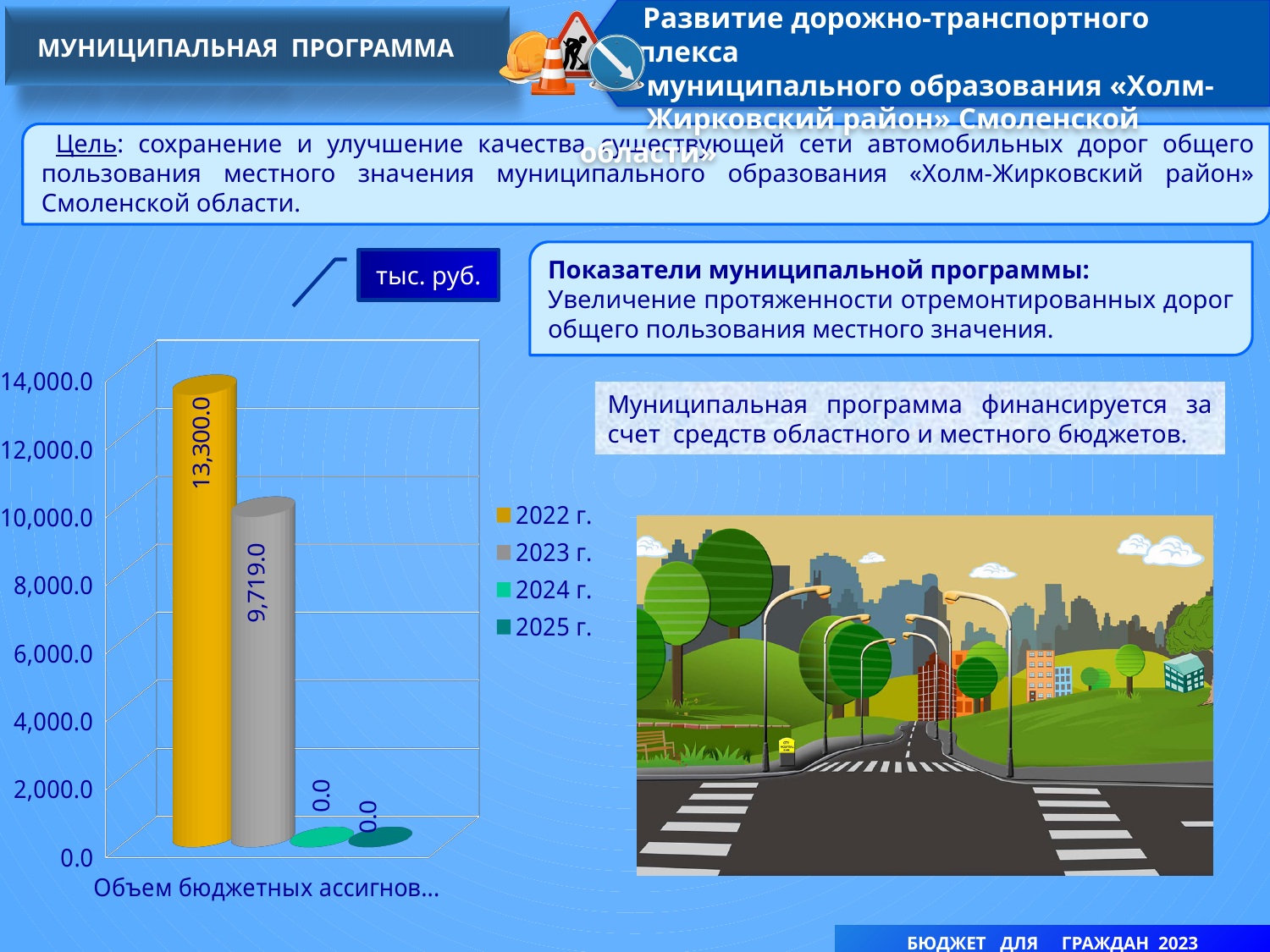
Is the value for 2022 г. greater or less than 12,000.0? greater What is the value for 2023 г. in the chart? 9,719.0 Which is larger, the value for 2022 г. or the value for 2023 г.? 2022 г. What is the difference between the values for 2022 г. and 2023 г.? 3,581.0 Is the value for 2023 г. greater or less than 10,000.0? less What is the value for 2025 г. in the chart? 0.0 Which year has the highest value in the chart? 2022 г. What kind of chart is shown on the slide? bar chart What unit is indicated for the chart values? тыс. руб. What is the value for 2022 г. in the chart? 13,300.0 What is the value for 2024 г. in the chart? 0.0 How many series does the chart legend list? 4